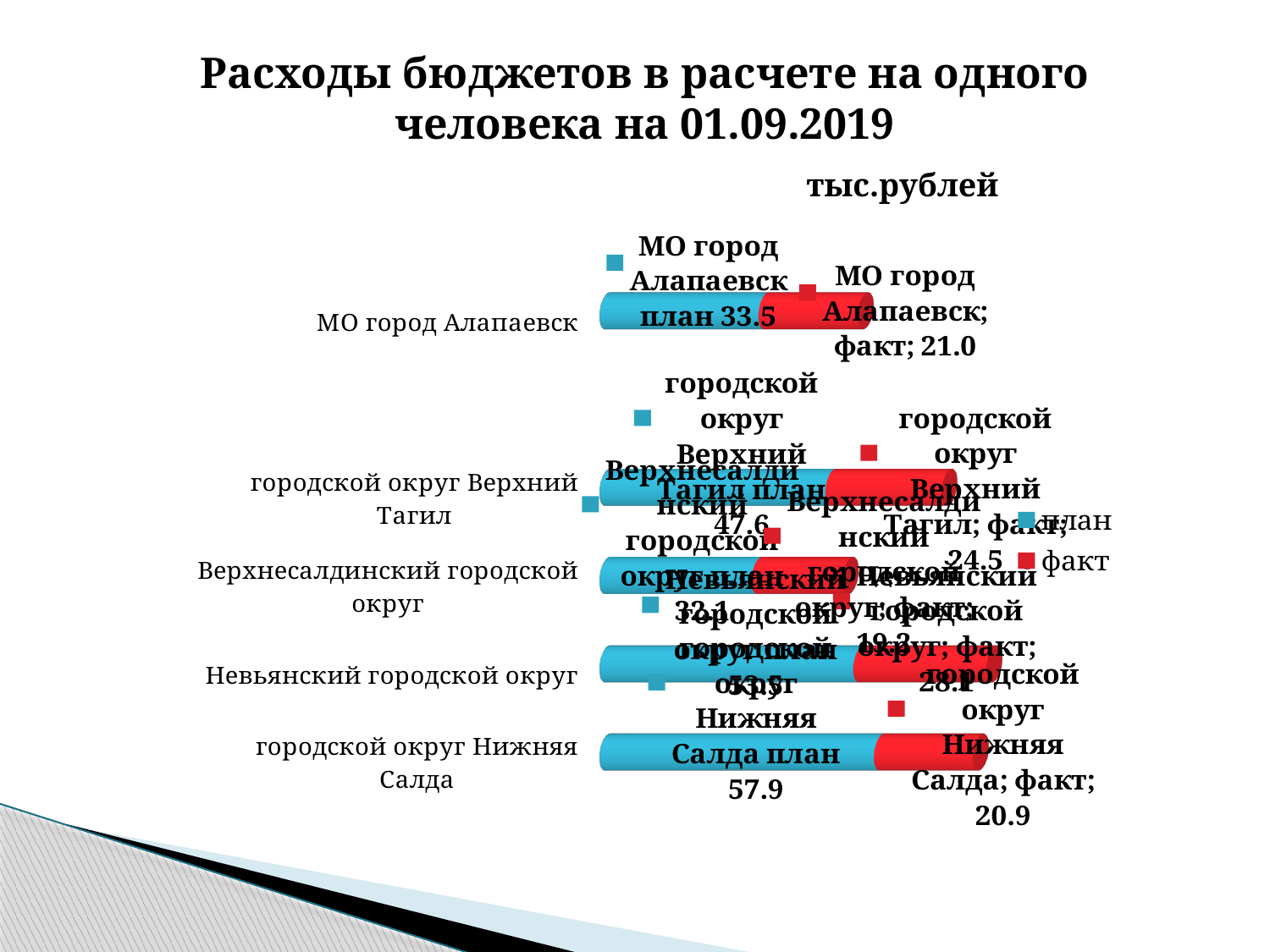
What are the two series named in the legend? план and факт What is the факт value for городской округ Верхний Тагил? 24.5 Which has the larger факт value: городской округ Верхний Тагил or городской округ Нижняя Салда? городской округ Верхний Тагил What kind of chart is shown on the slide? bar chart How many categories (municipalities) are plotted on the chart? 5 What is the difference between the план and факт values for МО город Алапаевск? 12.5 What is the факт value for МО город Алапаевск? 21.0 How many series does the legend list? 2 What is the план value for городской округ Нижняя Салда? 57.9 What is the факт value for городской округ Нижняя Салда? 20.9 What is the план value for МО город Алапаевск? 33.5 What is the план value for городской округ Верхний Тагил? 47.6